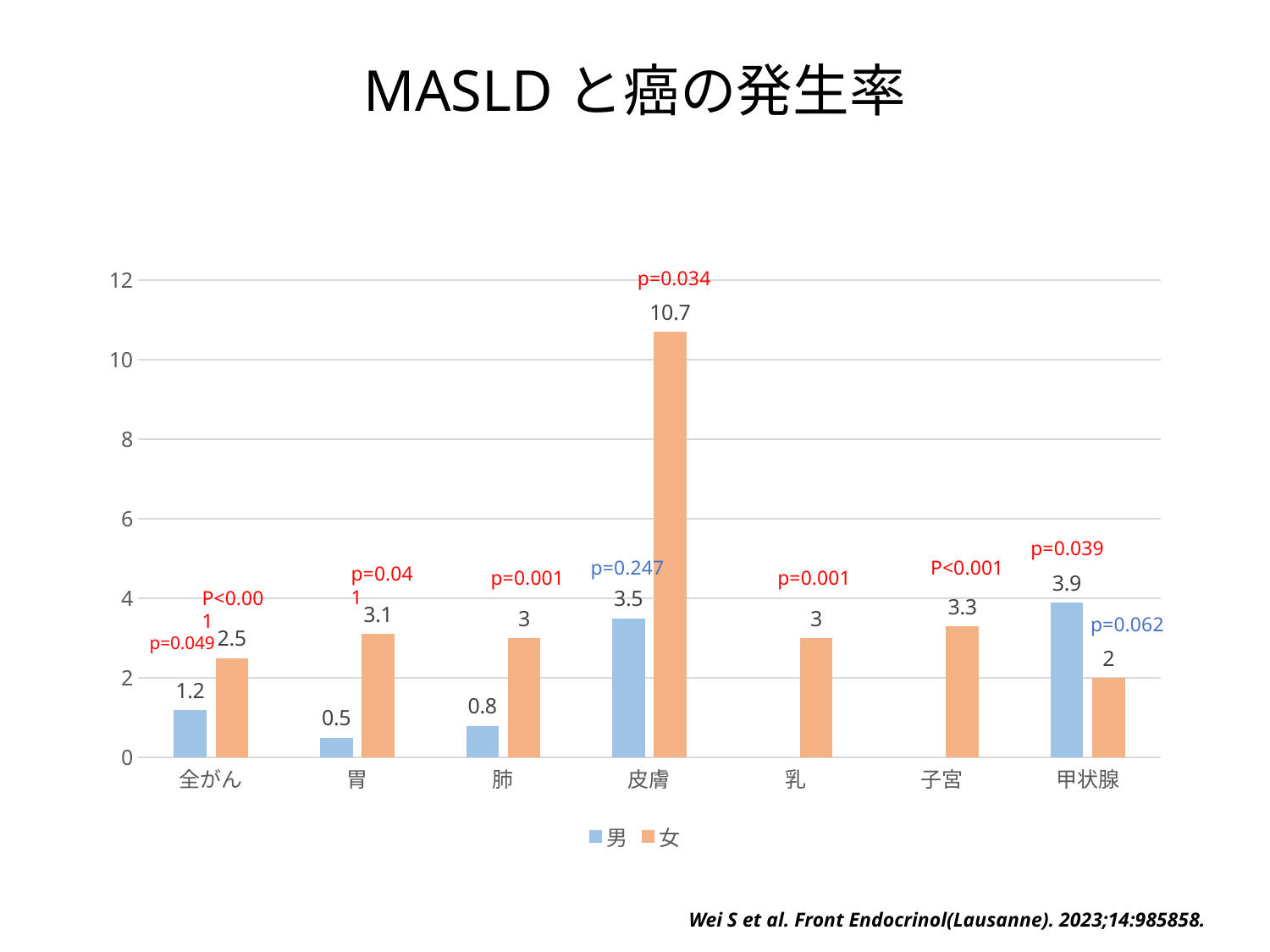
What is the value for 男 in the 胃 category? 0.5 What type of chart is shown on the slide? bar chart In the 甲状腺 category, which is larger, the 男 value or the 女 value? 男 What is the value for 男 in the 甲状腺 category? 3.9 How many categories are shown on the x axis? 7 What is the value for 女 in the 子宮 category? 3.3 Which category has the lowest value for 男 among those with a 男 bar? 胃 What is the difference between the 女 and 男 values in the 皮膚 category? 7.2 Which category has the highest value for 女? 皮膚 What is the title of the chart? MASLD と癌の発生率 How many series does the legend list? 2 What is the value for 女 in the 皮膚 category? 10.7